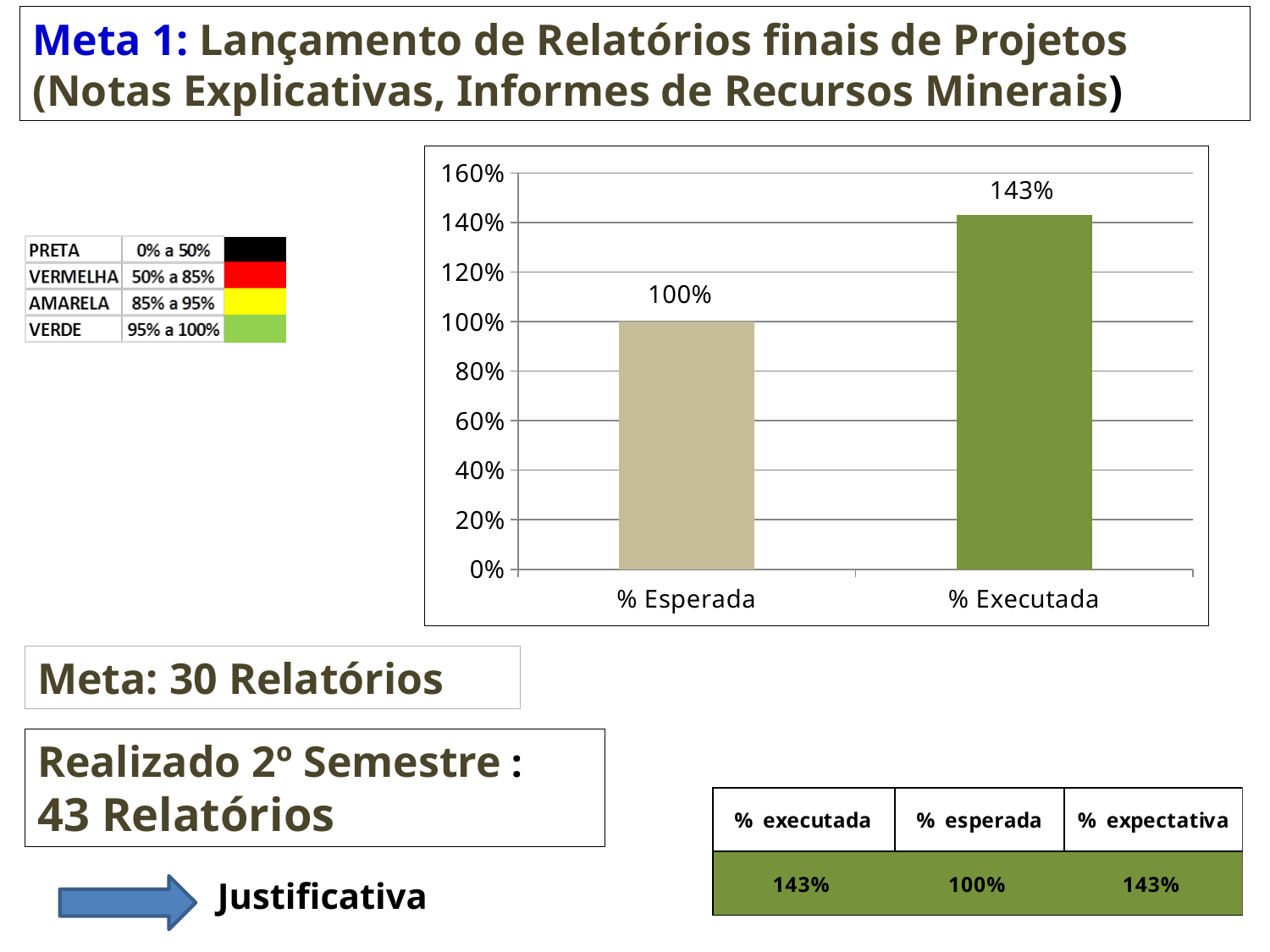
What is the difference between % Executada and % Esperada? 43% What is the value for % Executada? 143% What colour is the bar for % Executada? green Which is larger, % Esperada or % Executada? % Executada How many categories are shown on the chart? 2 What is the value for % Esperada? 100% What is the highest value shown on the y axis? 160% Is the value for % Executada greater or less than 120%? greater What kind of chart is shown? bar chart Which category has the lowest value? % Esperada Which category has the highest value? % Executada Is the value for % Esperada greater or less than 140%? less